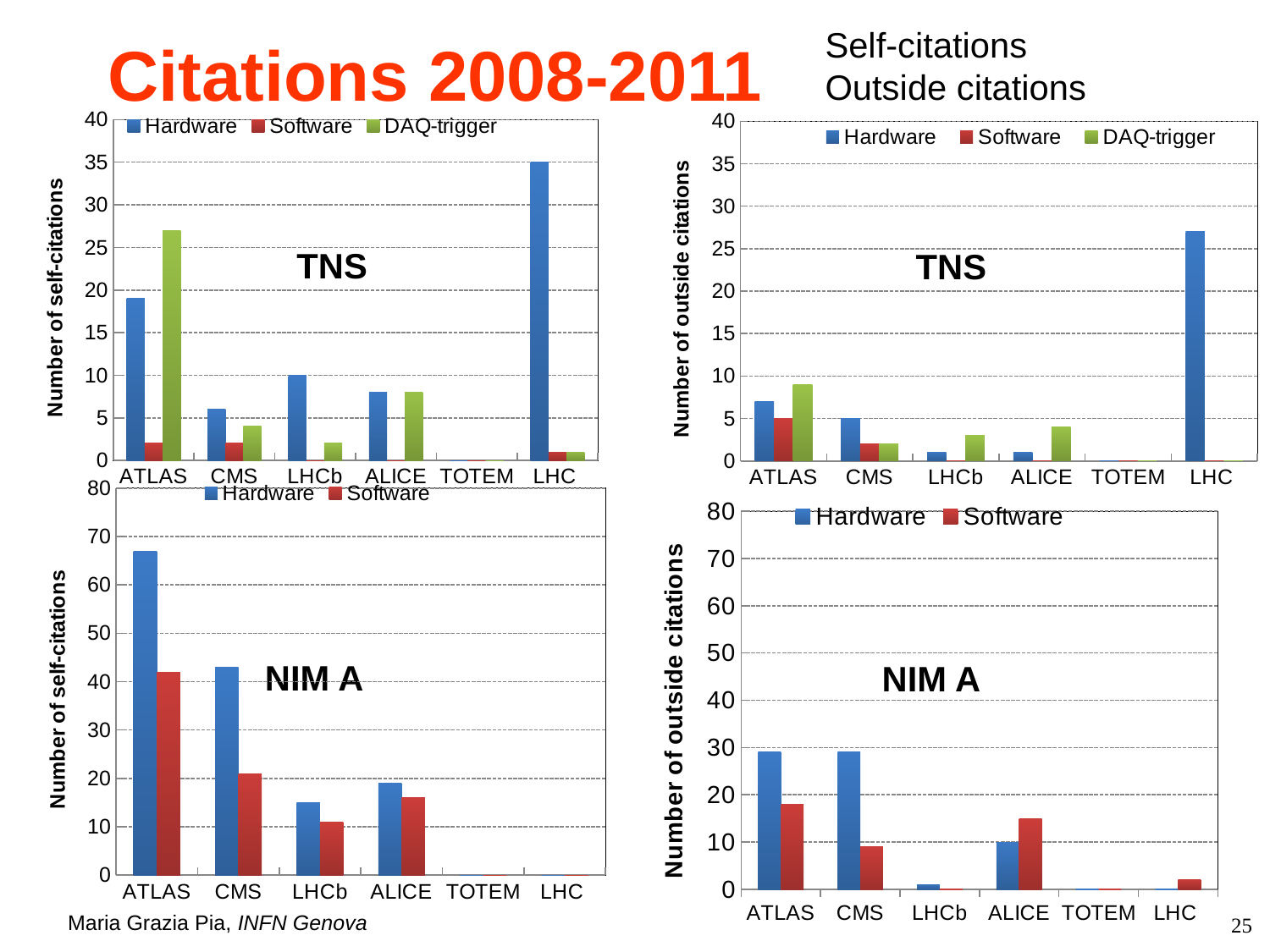
In the bottom-left chart (NIM A, number of self-citations), which is larger for CMS: Hardware or Software? Hardware How many series does the legend of the top-right chart (TNS, number of outside citations) list? 3 In the top-left chart (TNS, number of self-citations), is the DAQ-trigger value for ATLAS greater or less than 25? greater In the top-right chart (TNS, number of outside citations), which experiment has the highest Hardware bar? LHC In the top-left chart (TNS, number of self-citations), is the Hardware value for LHC greater or less than 30? greater How many series does the legend of the bottom-left chart (NIM A, number of self-citations) list? 2 In the bottom-right chart (NIM A, number of outside citations), which is larger for ALICE: Hardware or Software? Software In the top-right chart (TNS, number of outside citations), is the Hardware value for LHC greater or less than 25? greater In the top-left chart (TNS, number of self-citations), which experiment has the highest Hardware bar? LHC In the top-left chart (TNS, number of self-citations), which is larger for ATLAS: Hardware or DAQ-trigger? DAQ-trigger How many experiments are listed on the x axis of the bottom-right chart (NIM A, number of outside citations)? 6